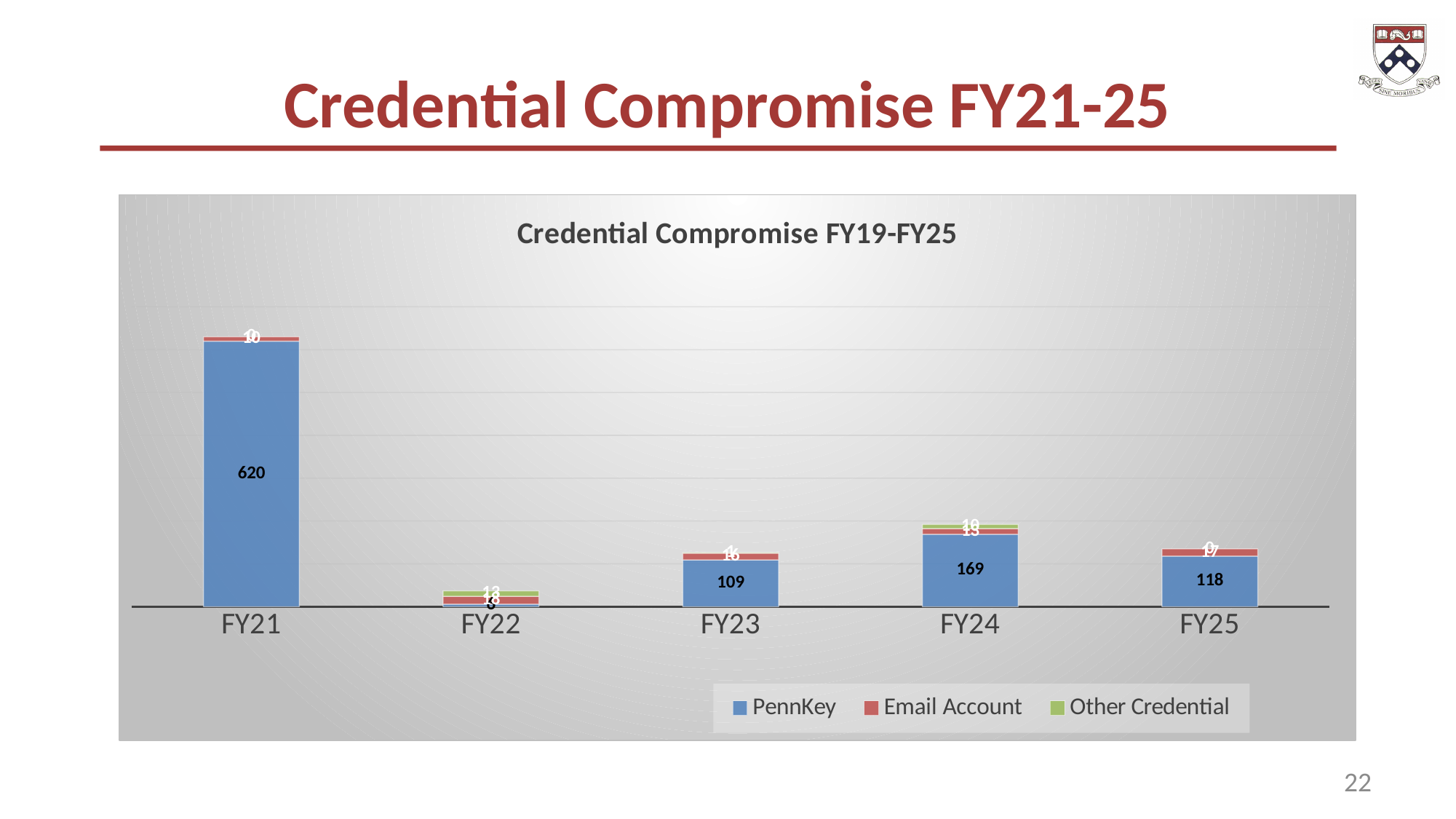
Which has a larger PennKey value, FY24 or FY25? FY24 What is the PennKey value for FY21? 620 How many series does the legend list? 3 What is the PennKey value for FY25? 118 What is the difference between the PennKey values for FY24 and FY25? 51 What is the PennKey value for FY24? 169 How many fiscal years are shown on the x axis? 5 What is the difference between the PennKey values for FY21 and FY23? 511 Which fiscal year has the lowest PennKey value? FY22 What is the PennKey value for FY23? 109 Which fiscal year has the highest PennKey value? FY21 What kind of chart is shown on the slide? Stacked bar chart